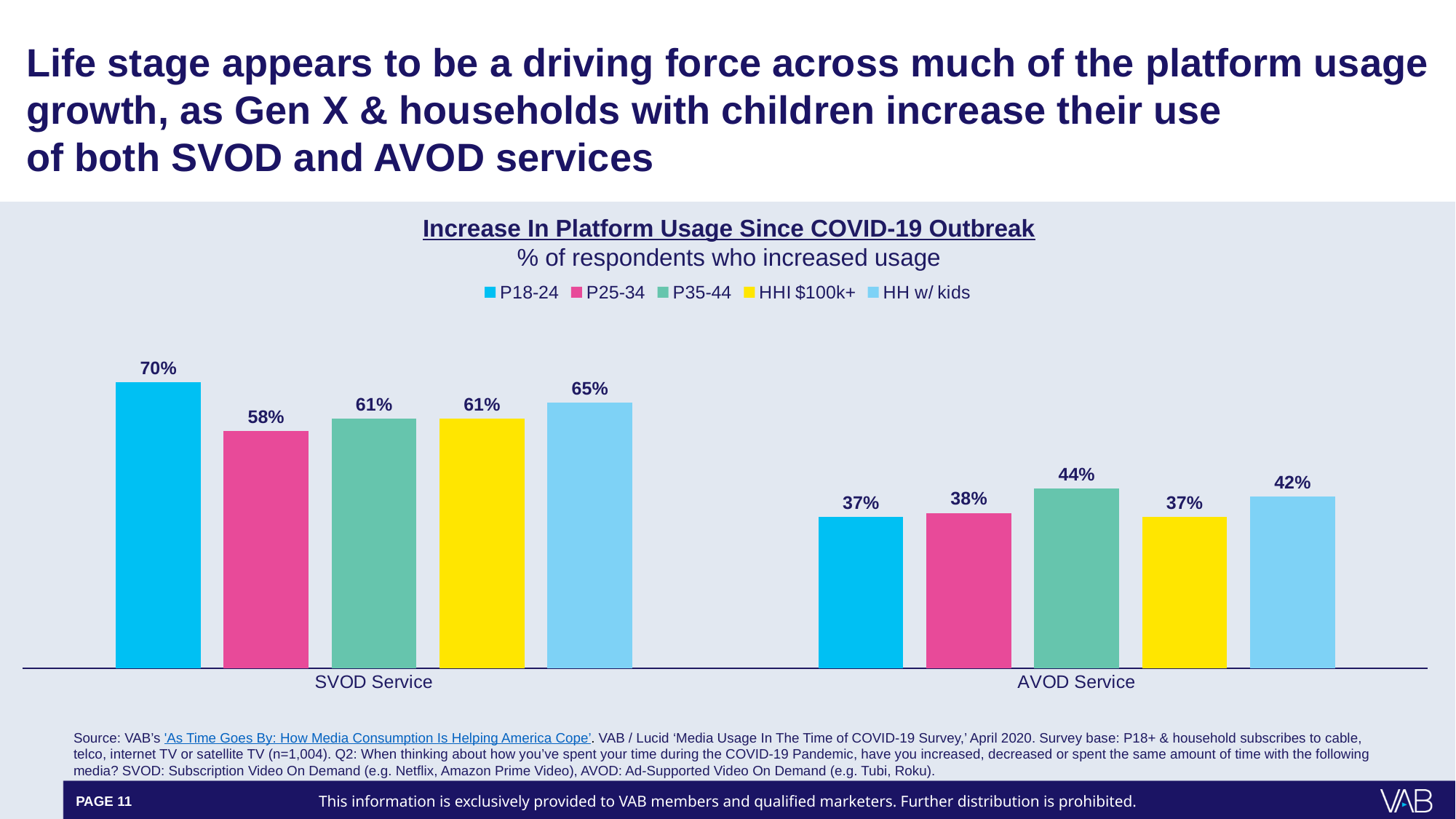
What is the difference between the P18-24 values for SVOD Service and AVOD Service? 33 percentage points How many series does the legend list? 5 Which series has the lowest value for SVOD Service? P25-34 What percentage of P18-24 respondents increased their SVOD Service usage? 70% What kind of chart is shown on the slide? Bar chart Which series has the highest value for AVOD Service? P35-44 Which is larger for HH w/ kids: the SVOD Service value or the AVOD Service value? SVOD Service What is the title of the chart? Increase In Platform Usage Since COVID-19 Outbreak How many categories are shown on the x axis? 2 Which series has the highest value for SVOD Service? P18-24 What is the value for HH w/ kids for AVOD Service? 42% What is the value for P35-44 for AVOD Service? 44%